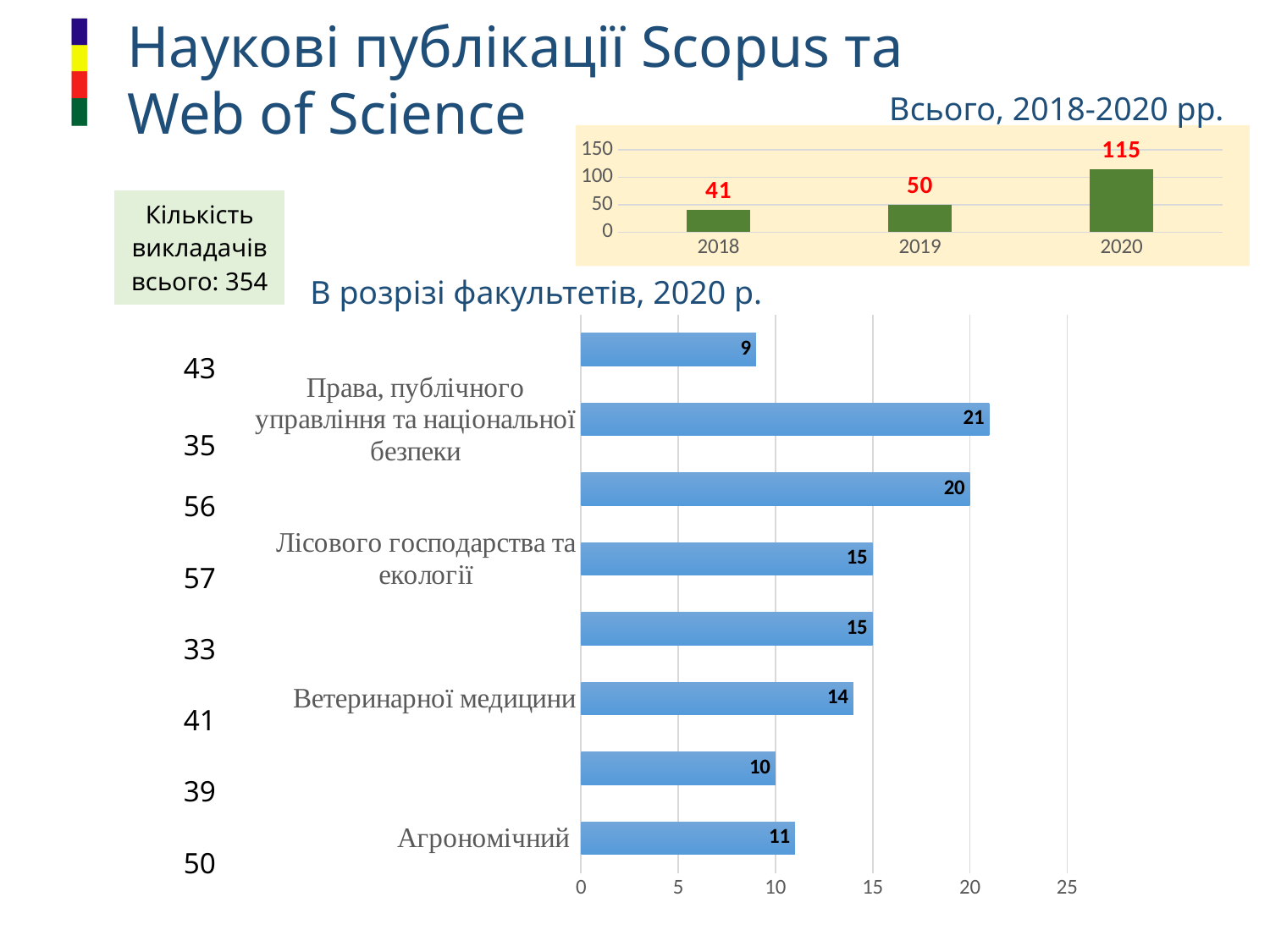
In the chart titled 'Всього, 2018-2020 рр.', do the values rise or fall from 2018 to 2020? rise In the chart titled 'В розрізі факультетів, 2020 р.', which faculty has the highest value? Права, публічного управління та національної безпеки What kind of chart is the one titled 'В розрізі факультетів, 2020 р.'? bar chart In the chart titled 'Всього, 2018-2020 рр.', what is the difference between the values for 2020 and 2019? 65 In the chart titled 'Всього, 2018-2020 рр.', what is the value for 2018? 41 In the chart titled 'Всього, 2018-2020 рр.', what is the value for 2020? 115 In the chart titled 'Всього, 2018-2020 рр.', which year has the highest value? 2020 In the chart titled 'В розрізі факультетів, 2020 р.', what is the value for 'Ветеринарної медицини'? 14 In the chart titled 'В розрізі факультетів, 2020 р.', what is the value for 'Права, публічного управління та національної безпеки'? 21 In the chart titled 'В розрізі факультетів, 2020 р.', what is the value for 'Агрономічний'? 11 In the chart titled 'В розрізі факультетів, 2020 р.', how many bars are plotted? 8 In the chart titled 'Всього, 2018-2020 рр.', how many years are plotted? 3